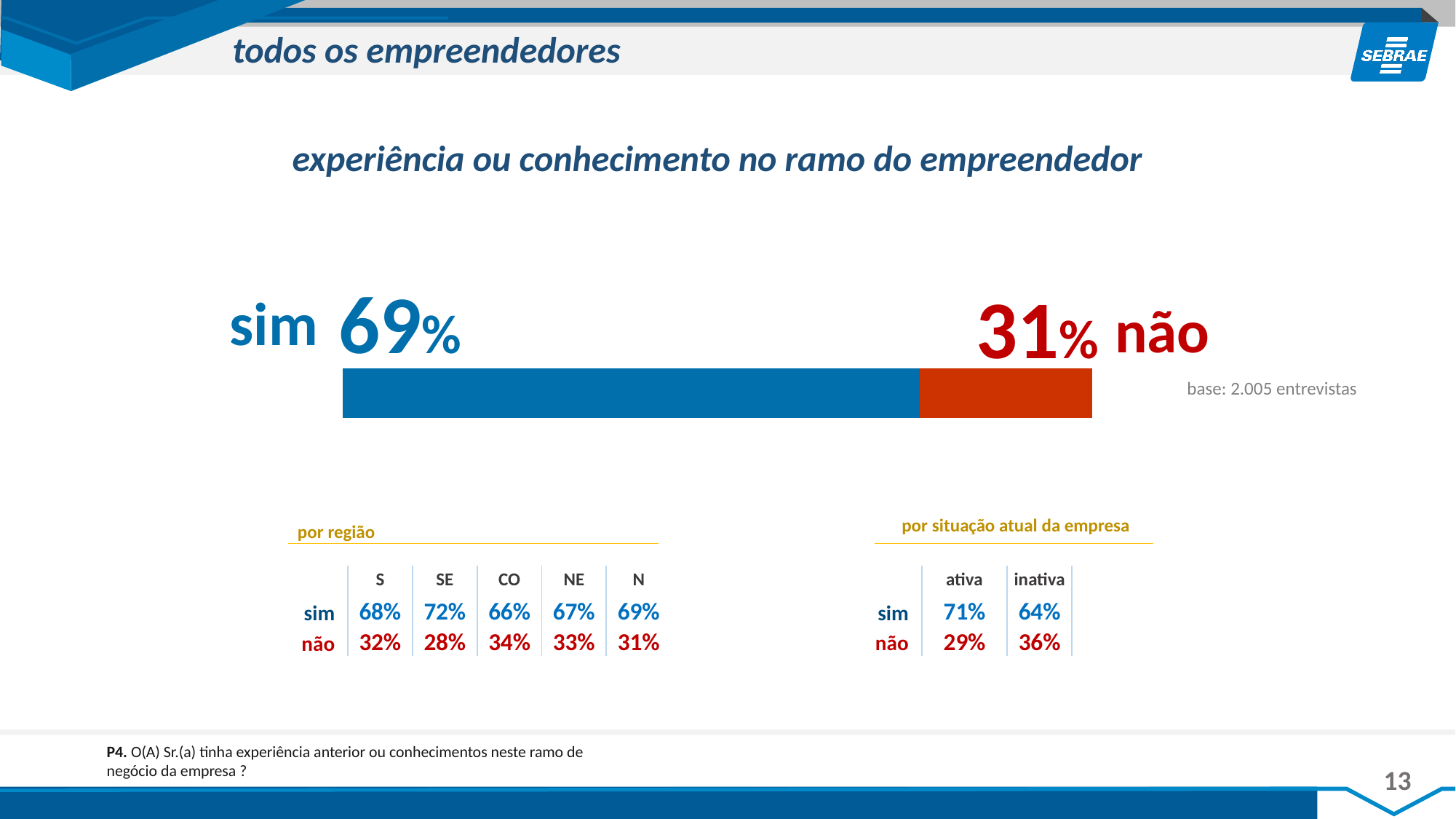
What percentage of entrepreneurs answered "não" in the main bar chart? 31% In the "por região" table, what is the "não" percentage for CO? 34% In the "por situação atual da empresa" table, what is the "sim" percentage for inativa? 64% What is the total of the two segments in the main stacked bar? 100% In the "por região" table, which region has the highest "sim" percentage? SE What colour is the "não" segment of the main bar? red What kind of chart shows the "sim" and "não" shares? bar chart What is the base (number of interviews) stated next to the main bar chart? 2.005 entrevistas What percentage of entrepreneurs answered "sim" in the main bar chart? 69% How many segments does the main stacked bar have? 2 Which segment of the main bar is larger, "sim" or "não"? sim What is the difference in percentage points between the "sim" and "não" segments of the main bar? 38